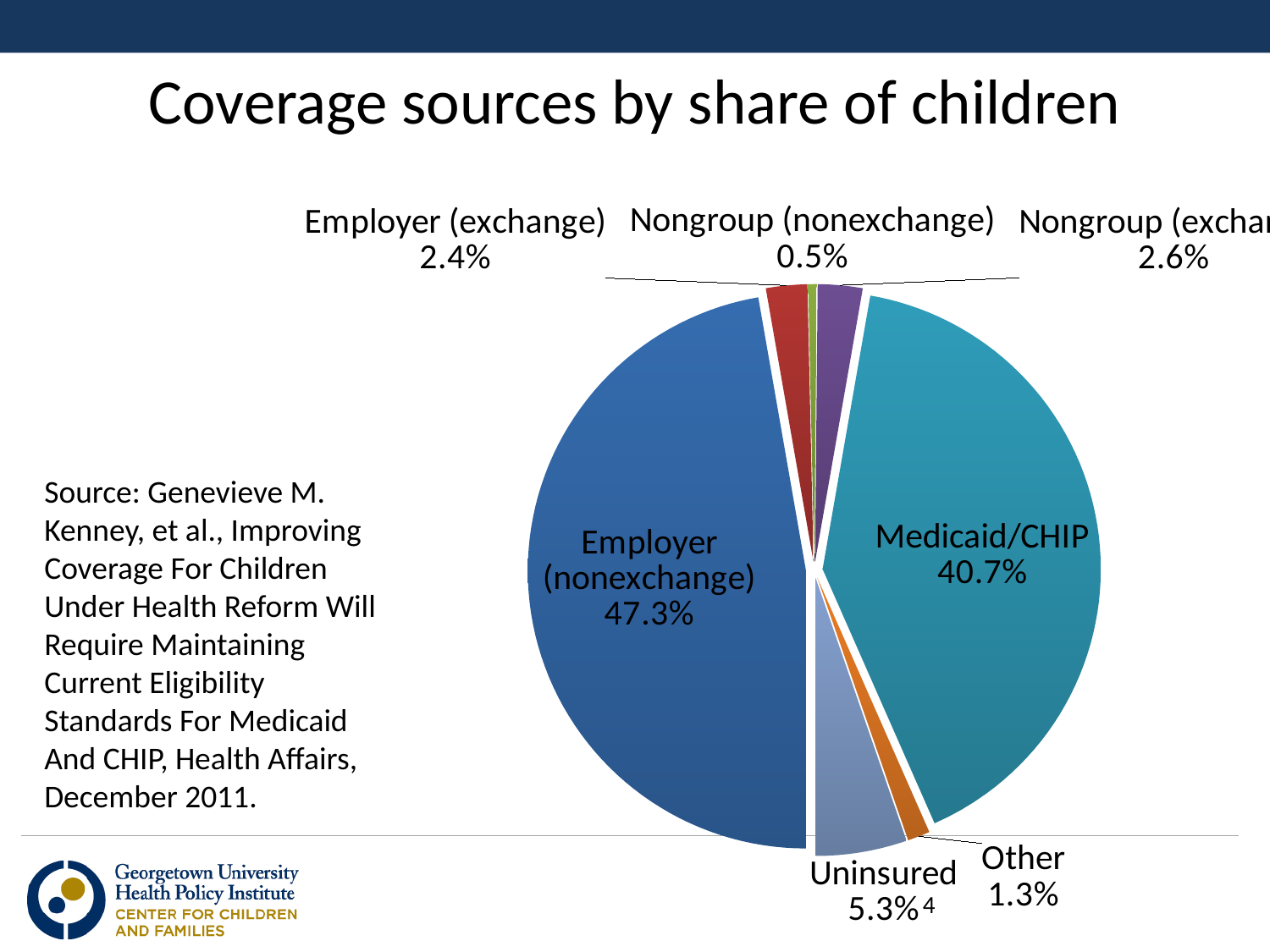
Which coverage source has the largest share of children? Employer (nonexchange) What share of children falls under Other? 1.3% What share of children is covered by Employer (exchange)? 2.4% What share of children is covered by Employer (nonexchange)? 47.3% What share of children is covered by Medicaid/CHIP? 40.7% Which is larger, the share for Uninsured or the share for Other? Uninsured Which coverage source has the smallest share of children? Nongroup (nonexchange) How many slices does the pie chart have? 7 What kind of chart is shown on the slide? Pie chart What is the difference in share between Employer (nonexchange) and Medicaid/CHIP? 6.6% What share of children is Uninsured? 5.3% What share of children is covered by Nongroup (nonexchange)? 0.5%